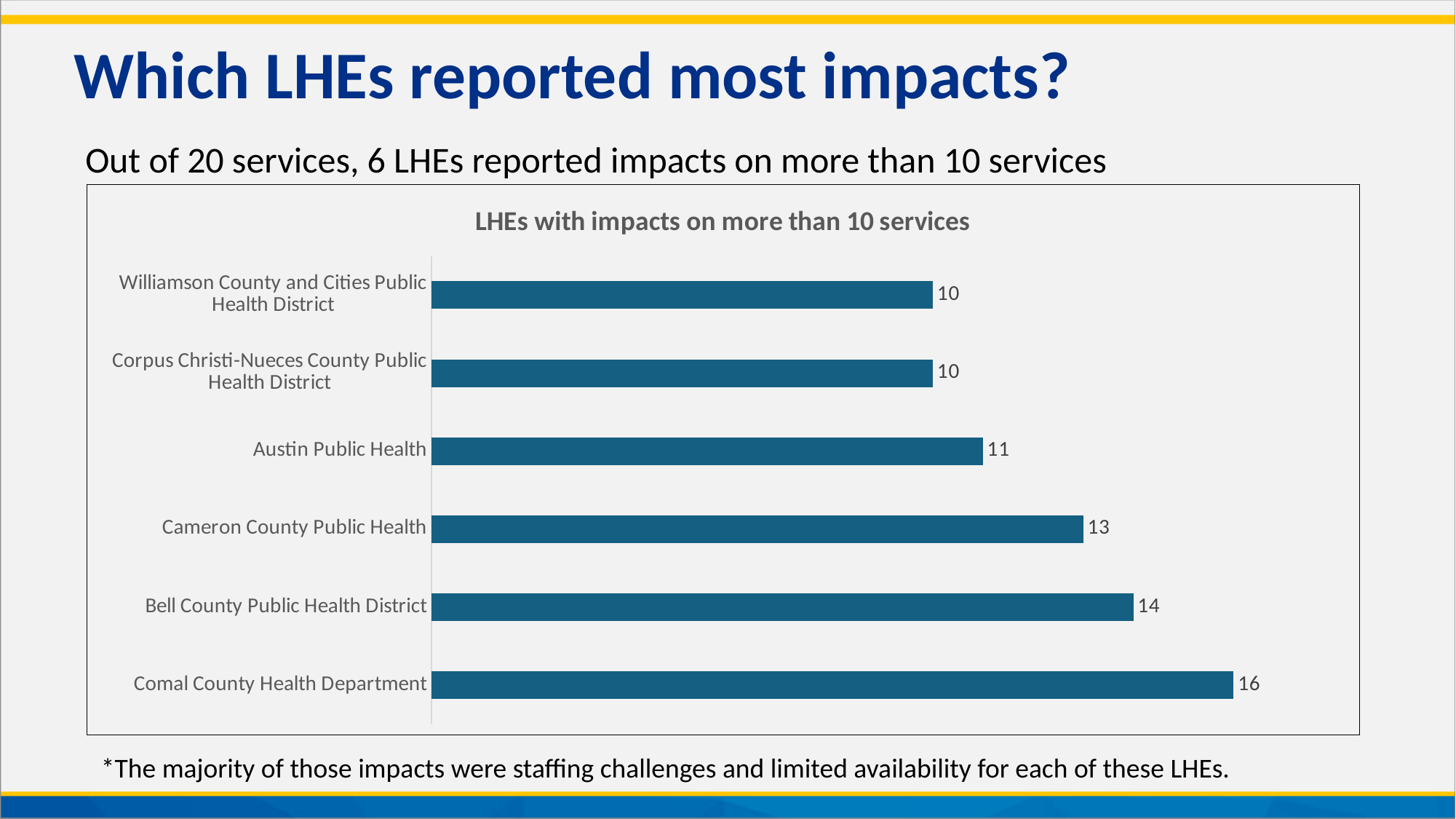
What is the difference between the values for Cameron County Public Health and Austin Public Health? 2 What value is shown for Cameron County Public Health? 13 What is the title of the chart? LHEs with impacts on more than 10 services Which two LHEs share the same value of 10? Williamson County and Cities Public Health District and Corpus Christi-Nueces County Public Health District What is the difference between the values for Comal County Health Department and Bell County Public Health District? 2 Which has a larger value, Bell County Public Health District or Cameron County Public Health? Bell County Public Health District What value is shown for Austin Public Health? 11 How many LHEs are shown in the chart? 6 What value is shown for Bell County Public Health District? 14 What kind of chart is shown on the slide? Bar chart What value is shown for Comal County Health Department? 16 Which LHE has the highest value in the chart? Comal County Health Department